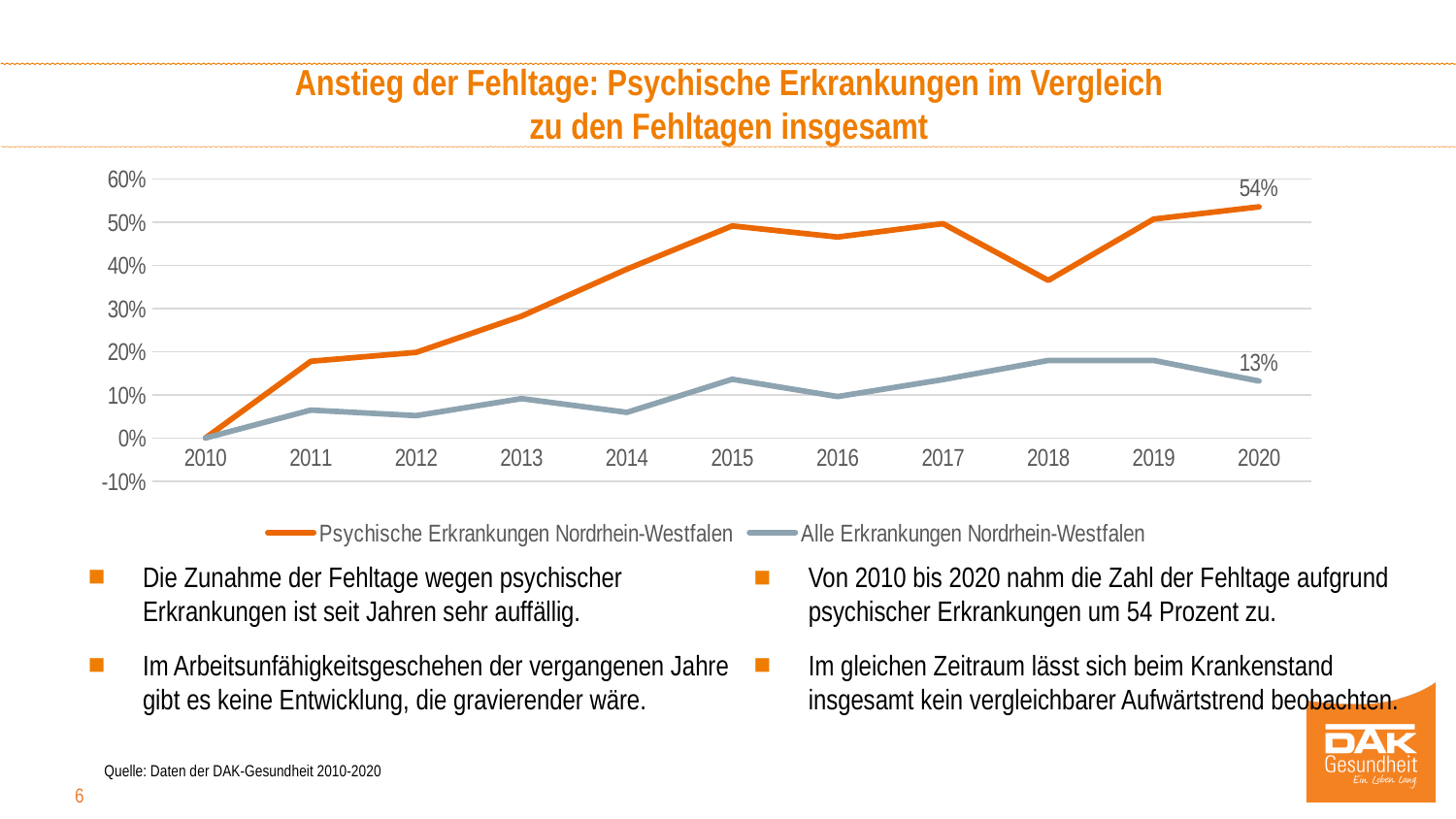
How many series does the legend list? 2 What is the title of the chart on the slide? Anstieg der Fehltage: Psychische Erkrankungen im Vergleich zu den Fehltagen insgesamt Which series has the higher value in 2020? Psychische Erkrankungen Nordrhein-Westfalen What is the difference between the 2020 values of Psychische Erkrankungen Nordrhein-Westfalen and Alle Erkrankungen Nordrhein-Westfalen? 41 percentage points What is the value for Psychische Erkrankungen Nordrhein-Westfalen in 2010? 0% Is the value for Psychische Erkrankungen Nordrhein-Westfalen in 2015 greater or less than 40%? greater How many years are shown on the x axis? 11 What is the value for Alle Erkrankungen Nordrhein-Westfalen in 2020? 13% What kind of chart is shown on the slide? line chart What is the value for Psychische Erkrankungen Nordrhein-Westfalen in 2020? 54% Is the value for Alle Erkrankungen Nordrhein-Westfalen in 2014 greater or less than 10%? less Does the line for Psychische Erkrankungen Nordrhein-Westfalen rise or fall overall from 2010 to 2020? rise